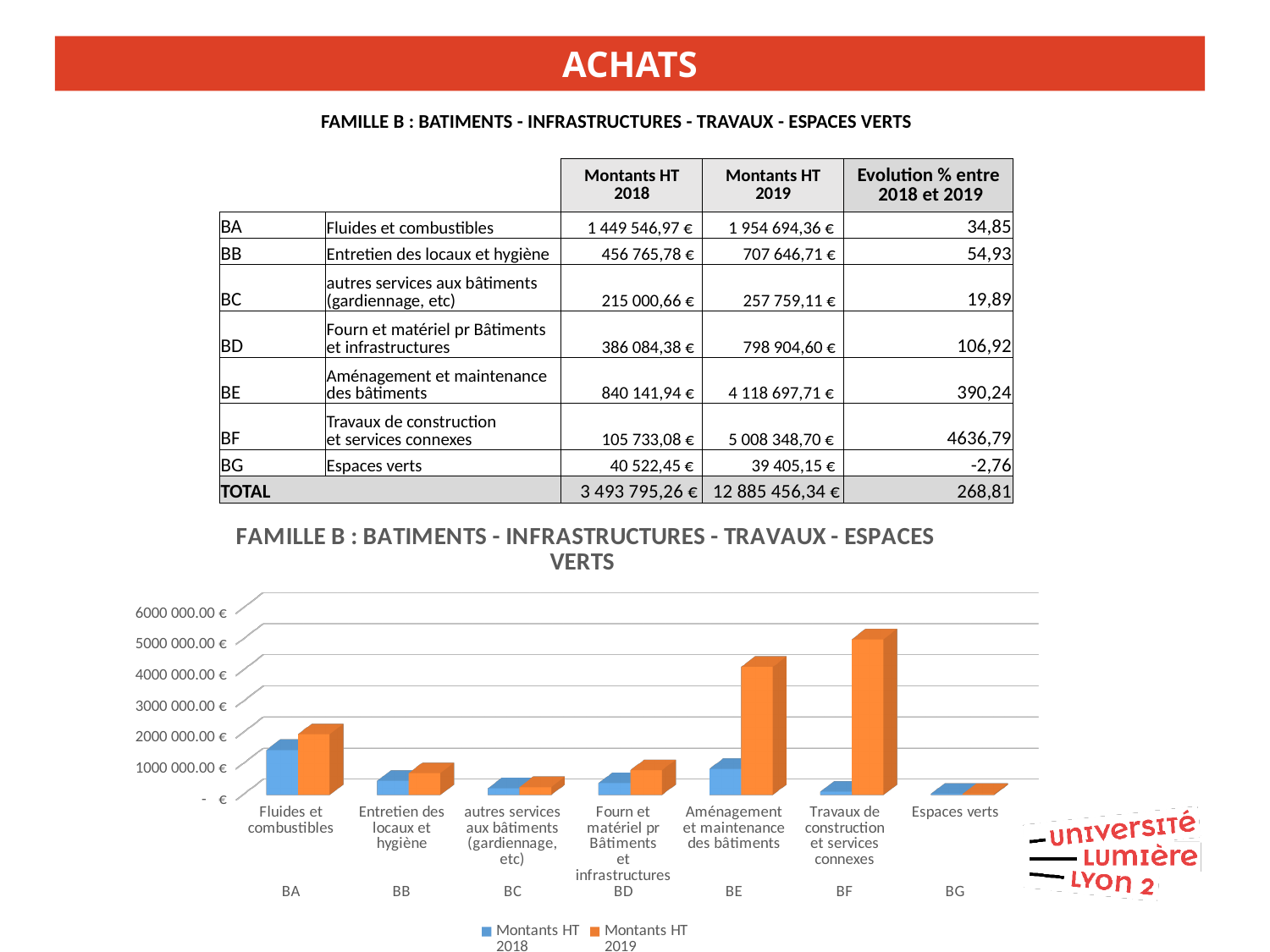
Which category has the lowest Montants HT 2019 bar in the chart? Espaces verts (BG) Is the Montants HT 2018 value for Fluides et combustibles greater or less than 1000 000.00 €? greater How many series does the chart legend list? 2 What is the title of the chart? FAMILLE B : BATIMENTS - INFRASTRUCTURES - TRAVAUX - ESPACES VERTS According to the table, what is the Montants HT 2018 value for Espaces verts (BG)? 40 522,45 € Which is larger in the chart: the Montants HT 2019 bar for Aménagement et maintenance des bâtiments or for Fluides et combustibles? Aménagement et maintenance des bâtiments How many categories are plotted along the x axis of the chart? 7 Is the Montants HT 2019 value for Travaux de construction et services connexes greater or less than 4000 000.00 €? greater According to the table, what is the Evolution % entre 2018 et 2019 for Travaux de construction et services connexes (BF)? 4636,79 According to the table, what is the Montants HT 2019 value for Fluides et combustibles (BA)? 1 954 694,36 € What kind of chart is shown on the slide? bar chart Which category has the highest Montants HT 2019 bar in the chart? Travaux de construction et services connexes (BF)